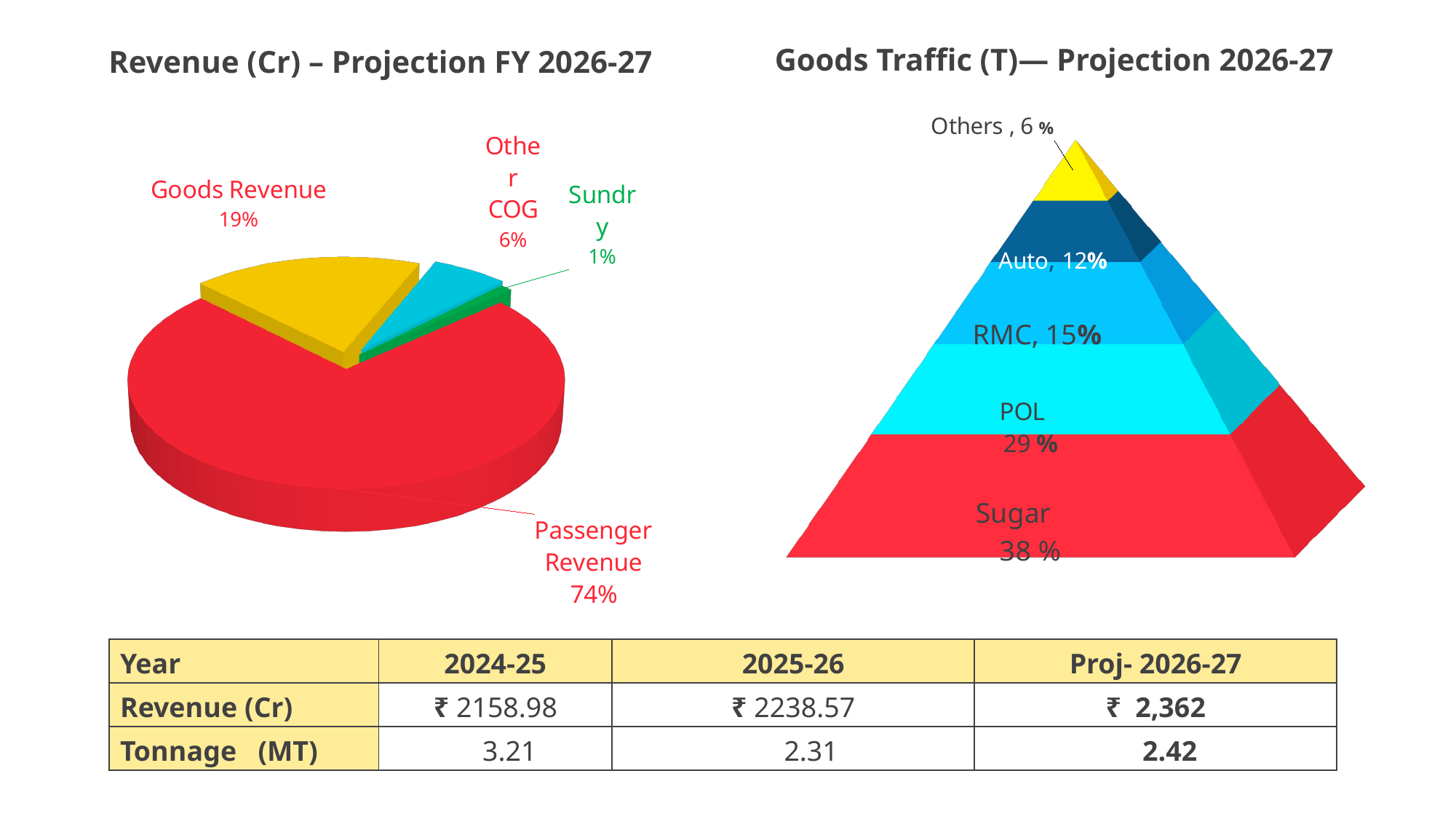
In the Goods Traffic (T)— Projection 2026-27 chart, how many categories are shown? 5 In the Goods Traffic (T)— Projection 2026-27 chart, which category has the largest share? Sugar In the Goods Traffic (T)— Projection 2026-27 chart, what share is RMC? 15% In the Revenue (Cr) – Projection FY 2026-27 chart, what share is Goods Revenue? 19% What kind of chart is the Revenue (Cr) – Projection FY 2026-27 chart? Pie chart In the Revenue (Cr) – Projection FY 2026-27 chart, which slice is the smallest? Sundry In the Revenue (Cr) – Projection FY 2026-27 chart, which slice is the largest? Passenger Revenue In the Revenue (Cr) – Projection FY 2026-27 chart, how many percentage points larger is Passenger Revenue than Goods Revenue? 55 In the Goods Traffic (T)— Projection 2026-27 chart, what share is POL? 29 % In the Revenue (Cr) – Projection FY 2026-27 chart, how many slices are there? 4 In the Revenue (Cr) – Projection FY 2026-27 chart, what share is Passenger Revenue? 74% In the Goods Traffic (T)— Projection 2026-27 chart, which is larger, Auto or RMC? RMC